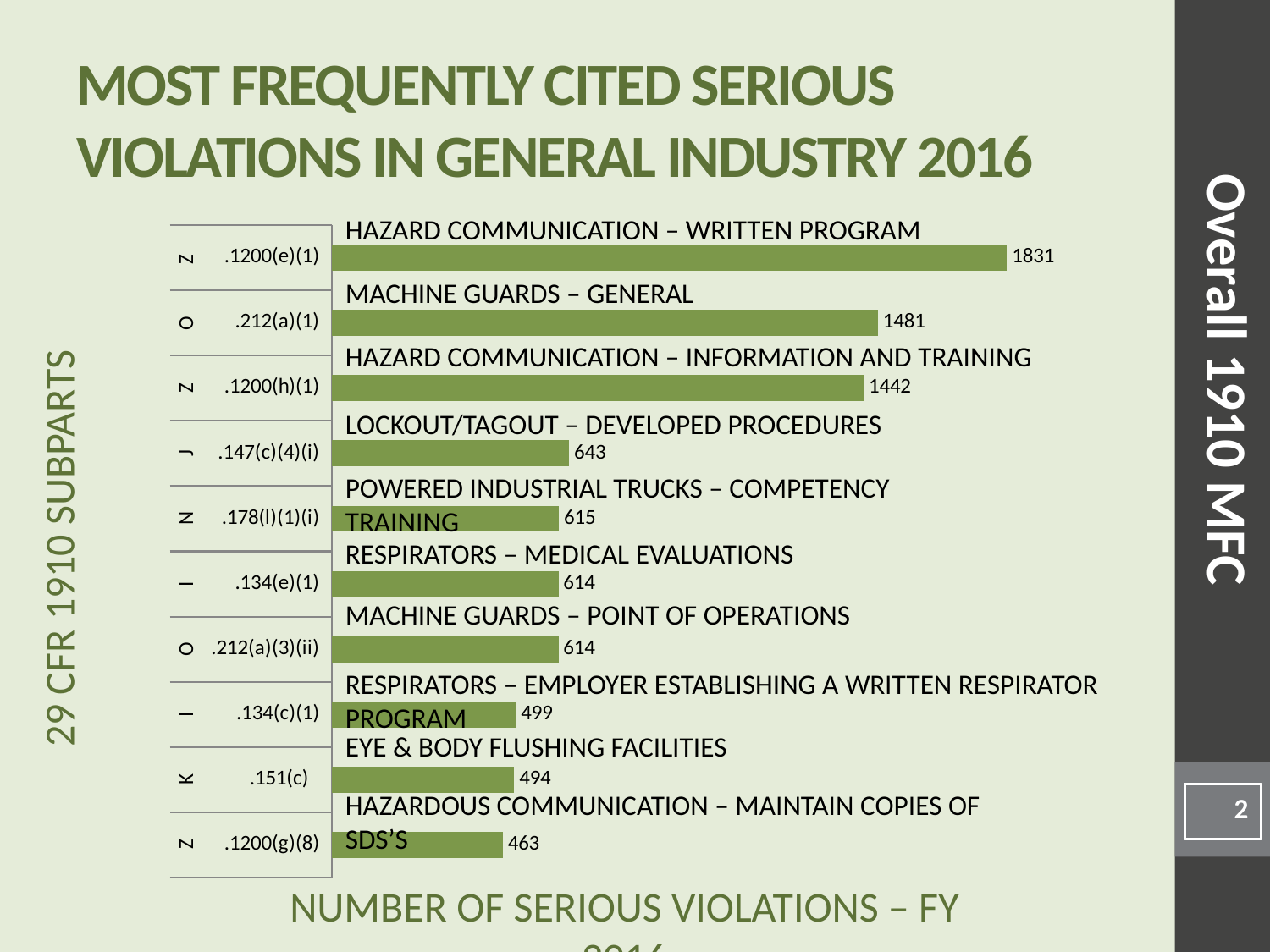
How many categories are plotted in the chart? 10 How many serious violations are shown for Hazard Communication – Written Program (.1200(e)(1))? 1831 What is the difference between the values for Hazard Communication – Information and Training and Lockout/Tagout – Developed Procedures? 799 What is the difference between the values for Hazard Communication – Written Program and Machine Guards – General? 350 What kind of chart is shown on the slide? bar chart Which category has the highest number of serious violations? Hazard Communication – Written Program What is the value for Eye & Body Flushing Facilities (.151(c))? 494 What is the value for Machine Guards – General (.212(a)(1))? 1481 What is the value for Lockout/Tagout – Developed Procedures (.147(c)(4)(i))? 643 Which category has the lowest number of serious violations? Hazardous Communication – Maintain Copies of SDS's Which is larger, the value for Respirators – Employer Establishing a Written Respirator Program or the value for Hazardous Communication – Maintain Copies of SDS's? Respirators – Employer Establishing a Written Respirator Program What is the label on the vertical axis of the chart? 29 CFR 1910 SUBPARTS